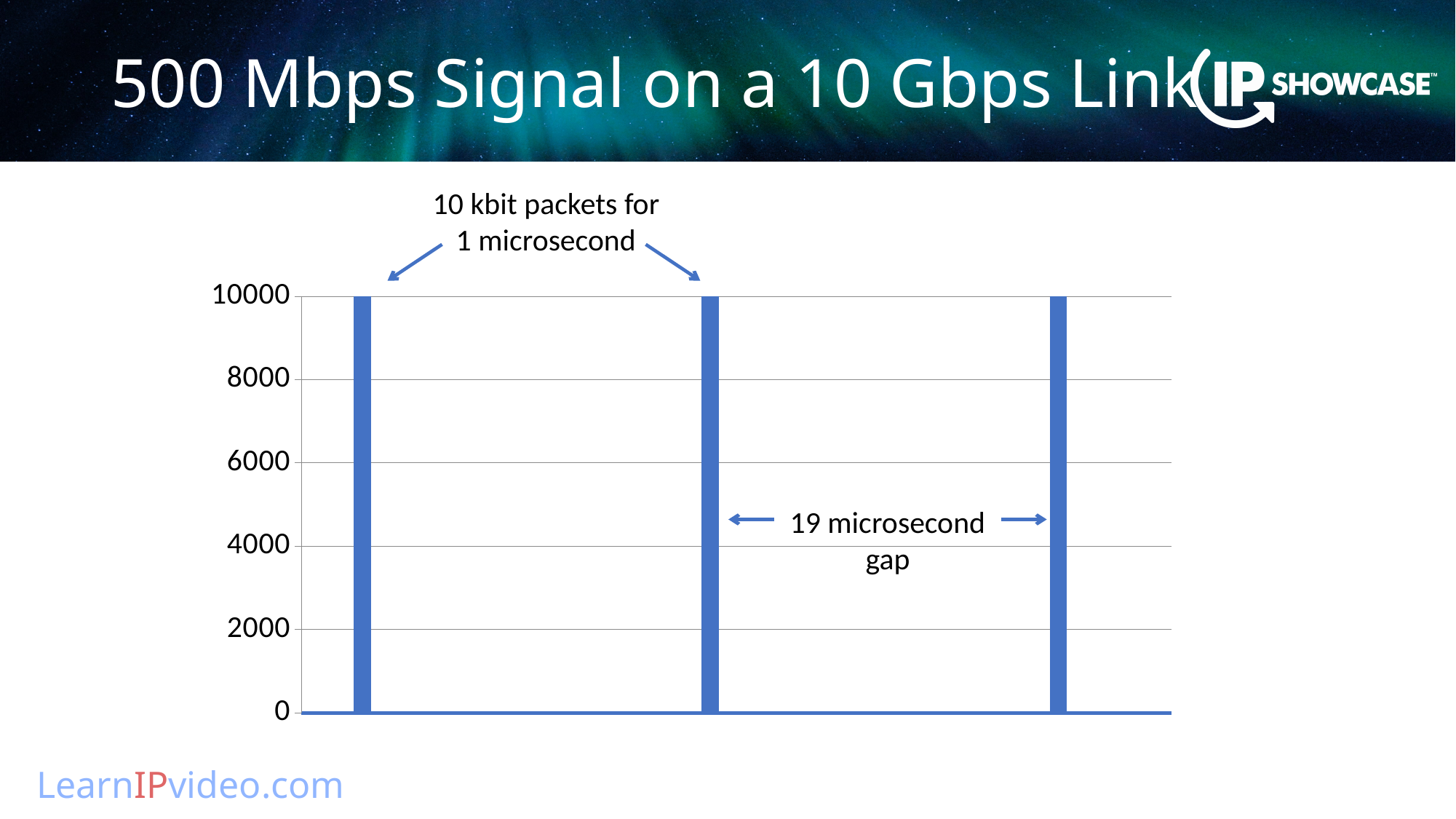
What value does the first (leftmost) bar reach on the y axis? 10000 What value does the middle bar reach on the y axis? 10000 Is the value of the leftmost bar greater or less than 8000? greater What is the lowest tick value shown on the y axis? 0 How many bars are plotted in the chart? 3 According to the annotation, what do the bars represent? 10 kbit packets for 1 microsecond What kind of chart is shown on the slide? bar chart Do the three bars all have the same height? yes What value does the rightmost bar reach on the y axis? 10000 What is the highest tick value shown on the y axis? 10000 Is the value of the rightmost bar greater or less than 6000? greater According to the annotation, how long is the gap between packets? 19 microsecond gap